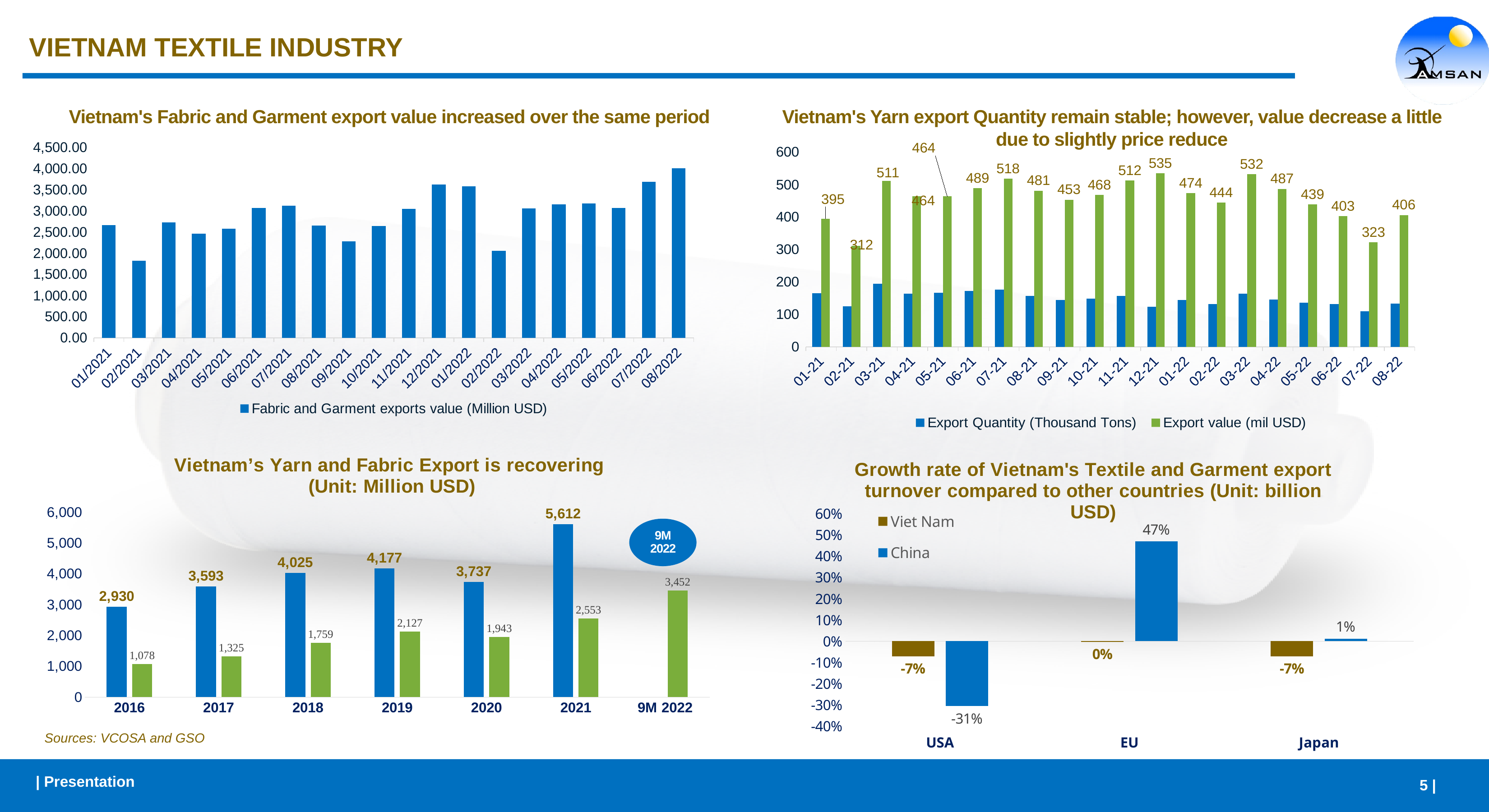
In the chart 'Growth rate of Vietnam's Textile and Garment export turnover compared to other countries', what is the growth rate for Viet Nam in Japan? -7% In the chart 'Vietnam's Yarn and Fabric Export is recovering', which is larger: the green bar for 2019 or the green bar for 2020? 2019 In the chart 'Vietnam's Yarn and Fabric Export is recovering', how many categories are shown on the x axis? 7 In the chart 'Vietnam's Yarn and Fabric Export is recovering', what is the value of the blue bar for 2021? 5,612 In the chart 'Vietnam's Fabric and Garment export value increased over the same period', is the value for 02/2021 greater or less than 2,000.00? less In the chart 'Vietnam's Yarn and Fabric Export is recovering', what is the value of the green bar for 9M 2022? 3,452 In the chart 'Vietnam's Fabric and Garment export value increased over the same period', which month has the highest value? 08/2022 How many series does the legend list in the chart 'Vietnam's Yarn export Quantity remain stable...'? 2 In the chart 'Vietnam's Yarn export Quantity remain stable...', what is the difference in Export value (mil USD) between 03-22 and 07-22? 209 In the chart 'Vietnam's Yarn export Quantity remain stable...', which month has the lowest Export value (mil USD)? 02-21 In the chart 'Growth rate of Vietnam's Textile and Garment export turnover compared to other countries', what is the growth rate for China in the EU? 47% In the chart 'Vietnam's Yarn export Quantity remain stable...', what is the Export value (mil USD) for 12-21? 535